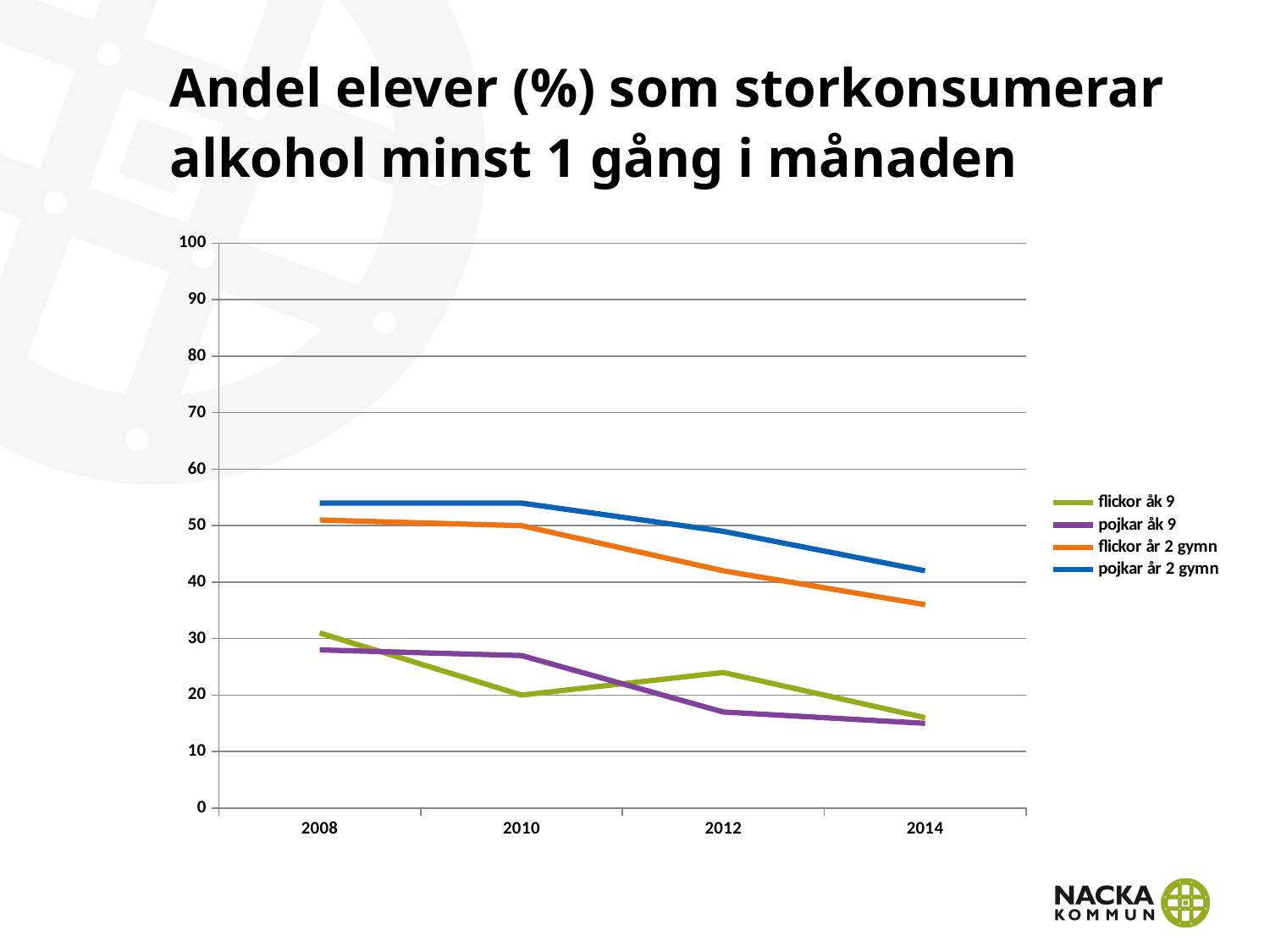
Is the value for pojkar åk 9 in 2008 greater or less than 30? less Is the value for flickor år 2 gymn in 2014 greater or less than 40? less What colour is the line for flickor år 2 gymn? orange Is the value for pojkar år 2 gymn in 2008 greater or less than 50? greater In 2012, which is larger: flickor åk 9 or pojkar åk 9? flickor åk 9 How many years are shown on the x axis? 4 Which series has the lowest value in 2012? pojkar åk 9 How many series does the legend list? 4 Does the value for pojkar år 2 gymn rise or fall from 2008 to 2014? fall What kind of chart is shown on the slide? line chart Which series has the highest value in 2014? pojkar år 2 gymn